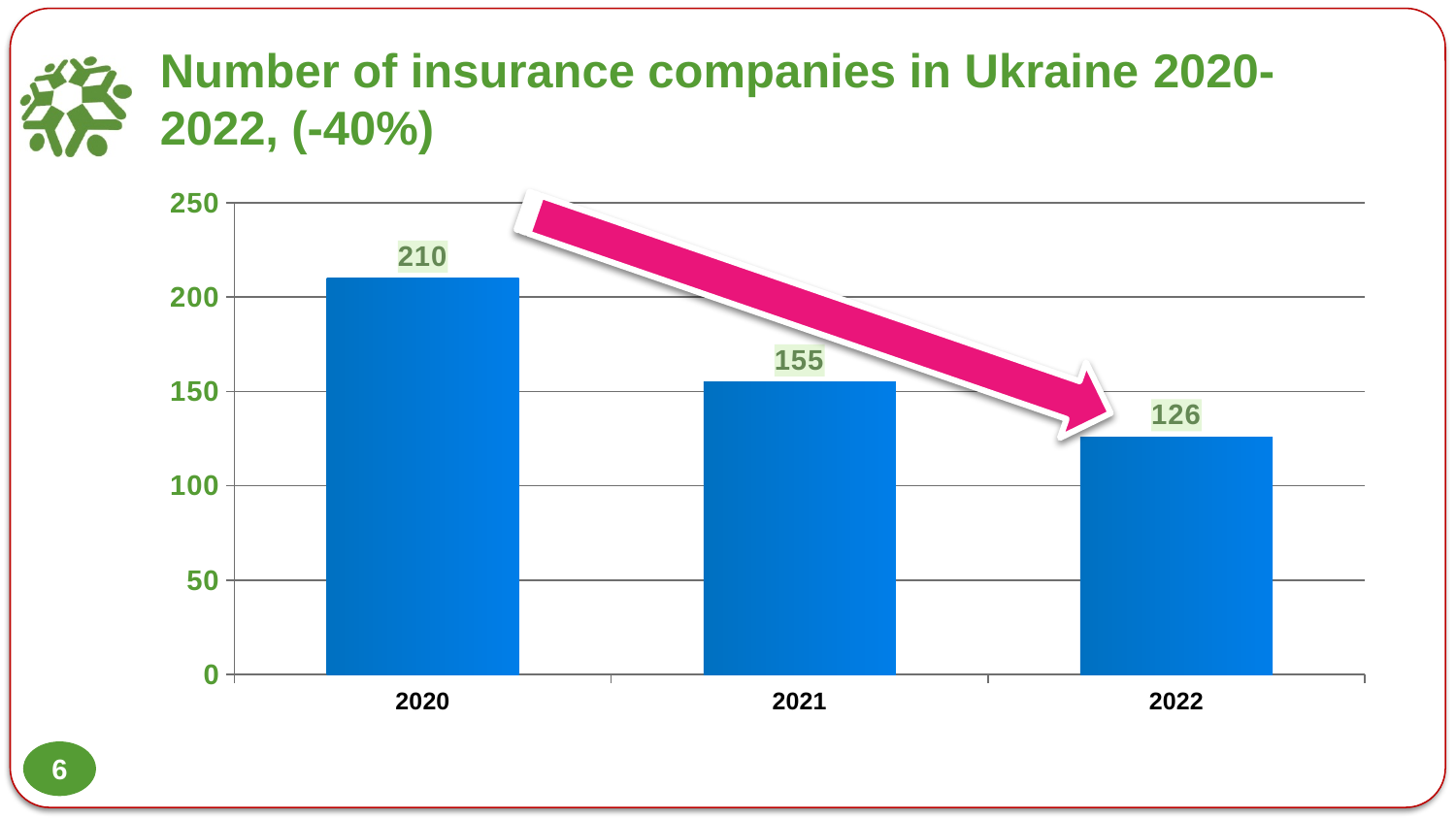
What is the number of insurance companies in Ukraine in 2022? 126 Which year has the highest number of insurance companies? 2020 How many years are shown on the chart? 3 What is the difference between the number of insurance companies in 2020 and 2021? 55 Do the values rise or fall from 2020 to 2022? fall Which year has more insurance companies, 2021 or 2022? 2021 Which year has the lowest number of insurance companies? 2022 What is the number of insurance companies in Ukraine in 2021? 155 What is the number of insurance companies in Ukraine in 2020? 210 Is the value for 2021 greater or less than 150? greater What is the difference between the number of insurance companies in 2020 and 2022? 84 What kind of chart is shown on the slide? bar chart